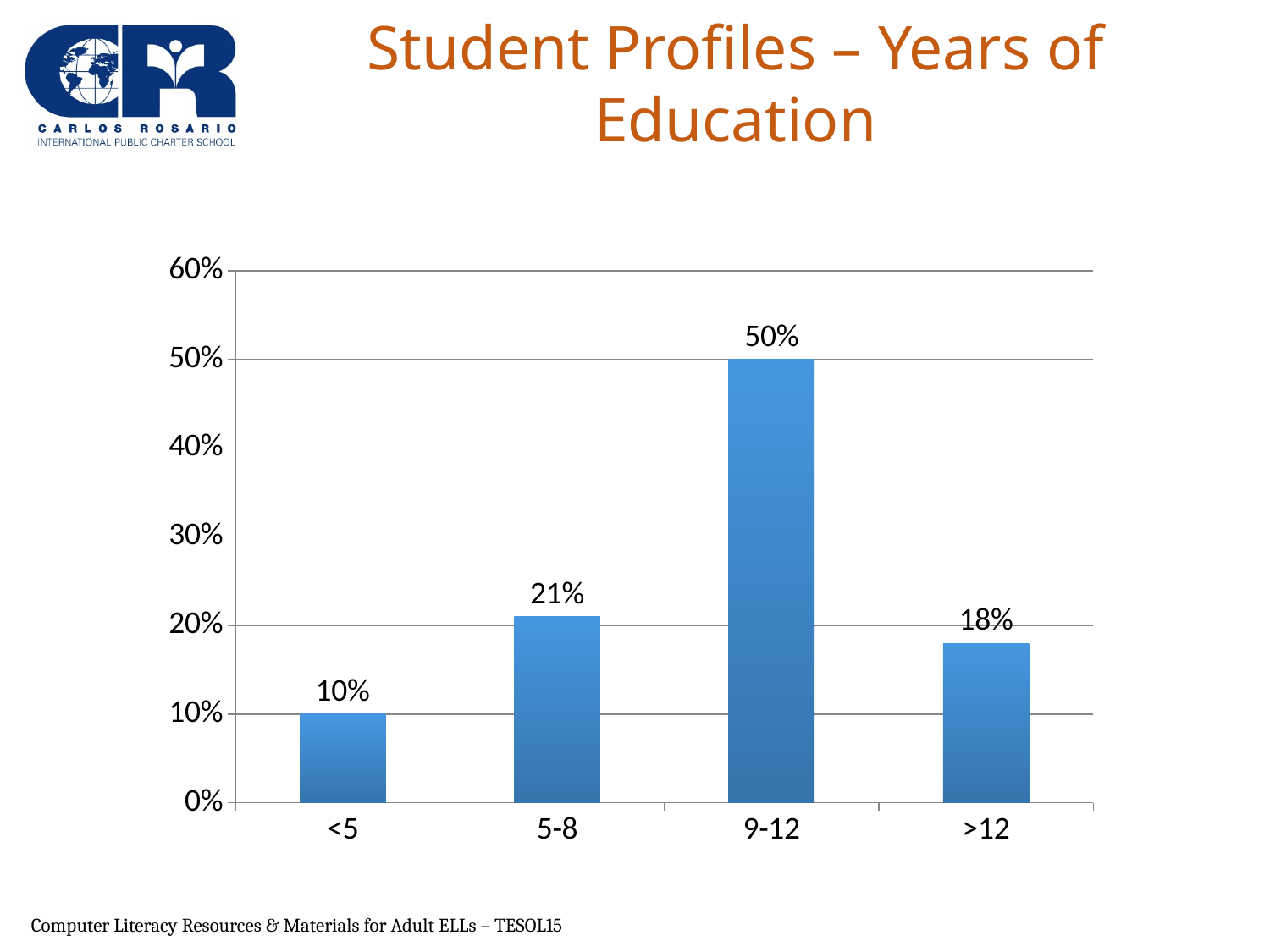
What is the difference between the >12 category and the <5 category? 8% What is the title of the slide containing the chart? Student Profiles – Years of Education What is the difference between the 9-12 category and the 5-8 category? 29% Which years-of-education category has the lowest percentage? <5 Which years-of-education category has the highest percentage? 9-12 What percentage of students have more than 12 years of education (>12)? 18% How many years-of-education categories are shown on the x axis? 4 What kind of chart is shown on the slide? Bar chart What is the value shown for the 9-12 years of education category? 50% What is the value shown for the 5-8 years of education category? 21% What percentage of students have fewer than 5 years of education (<5)? 10% Which is larger, the value for 5-8 or the value for >12? 5-8